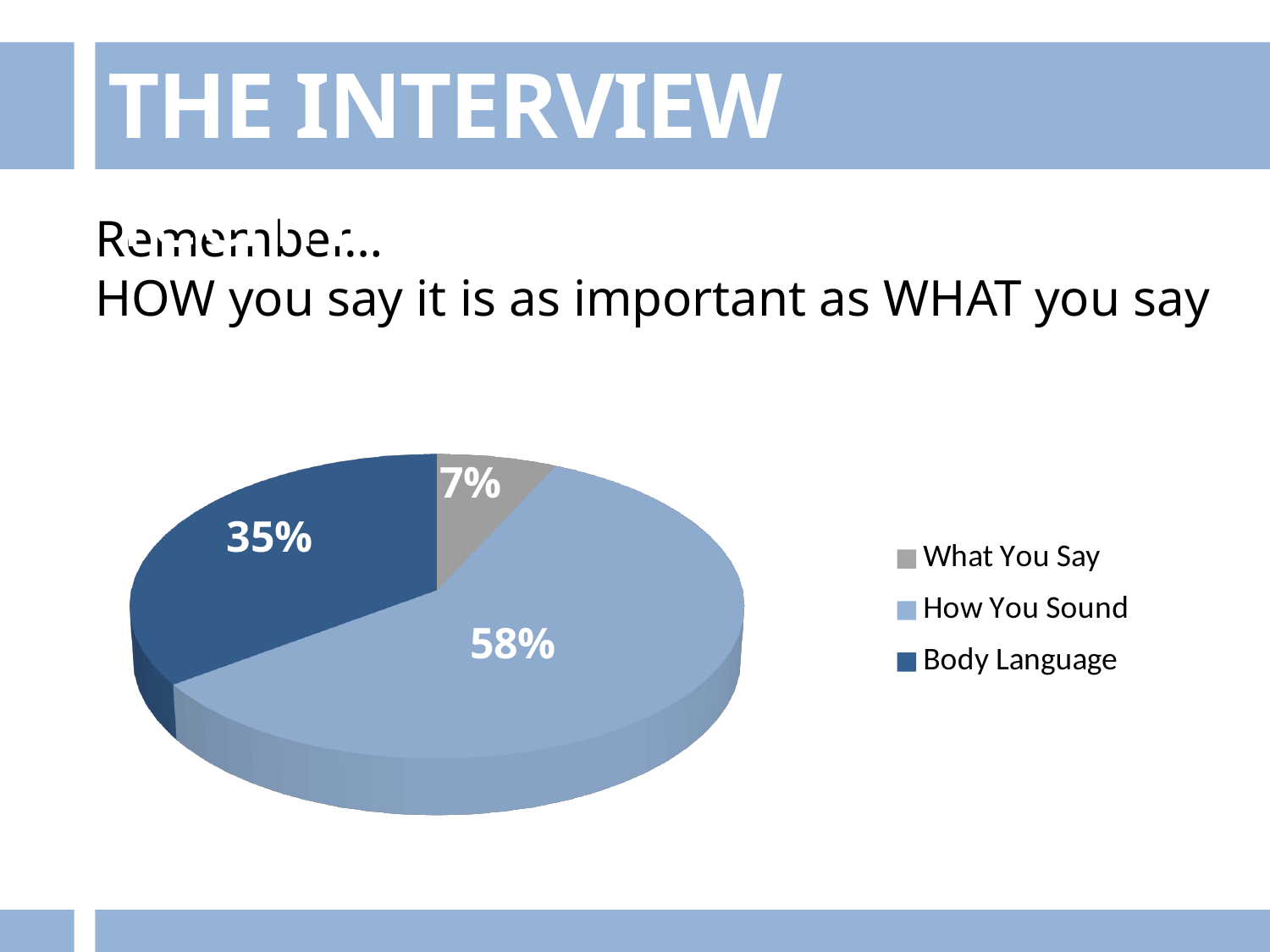
What kind of chart is shown on the slide? pie chart What share of the pie does Body Language represent? 35% What percentage does the chart show for How You Sound? 58% Which category has the largest slice of the pie? How You Sound Which legend entry is shown in grey? What You Say What percentage does the chart show for What You Say? 7% Which category has the smallest slice of the pie? What You Say Which is larger, the slice for Body Language or the slice for What You Say? Body Language What percentage does the chart show for Body Language? 35% How many entries does the legend list? 3 How many categories does the pie chart show? 3 What is the difference in percentage points between How You Sound and Body Language? 23